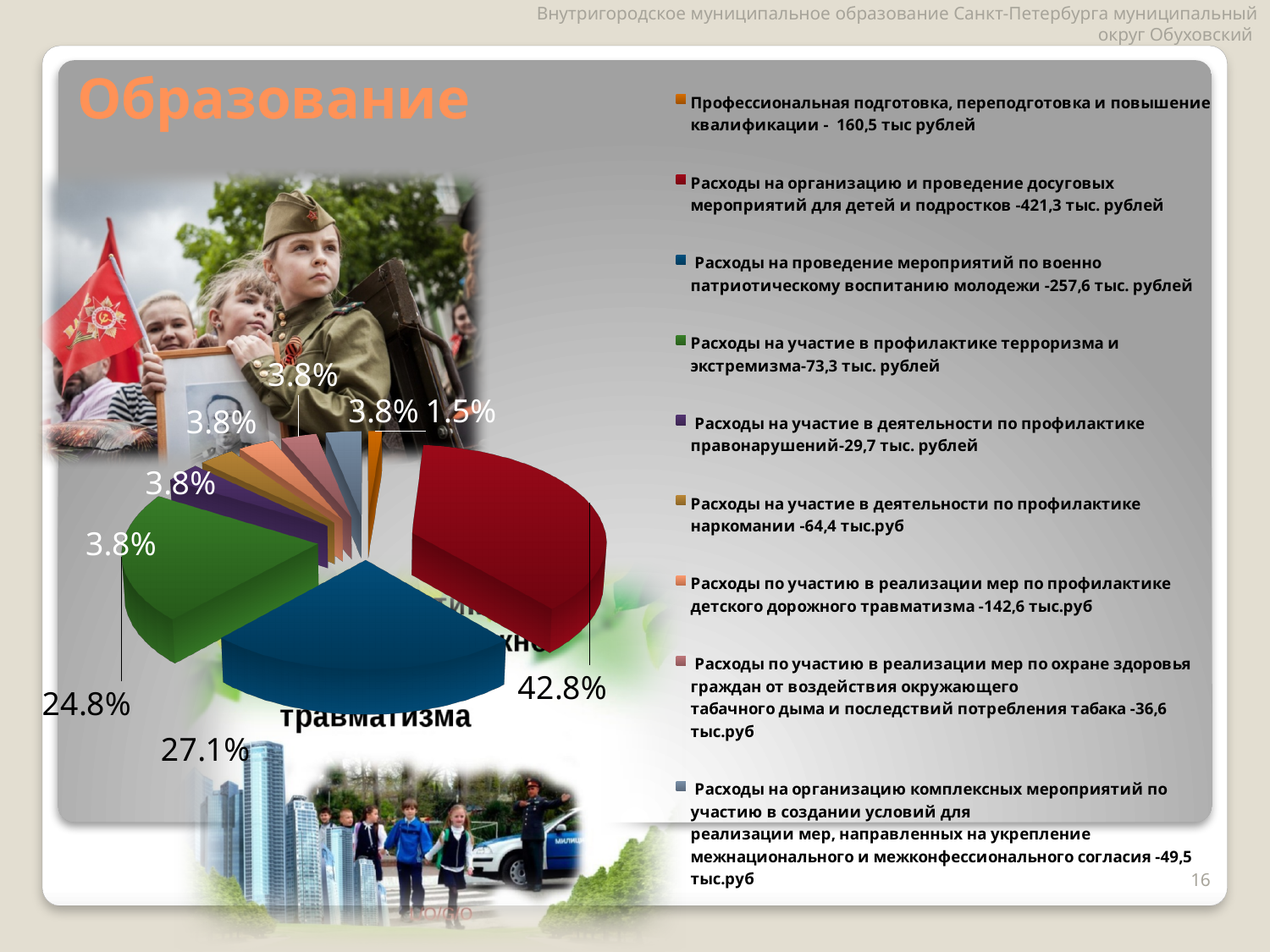
What is the difference in percentage points between the largest slice (42.8%) and the second largest slice (27.1%)? 15.7 Is the largest slice of the pie chart greater or less than 40%? greater What is the percentage shown for the largest slice of the pie chart? 42.8% What is the title of the slide containing the pie chart? Образование What percentage is shown for the green slice of the pie chart? 24.8% Which slice is larger: the red slice or the dark blue slice? the red slice What kind of chart is shown on the slide? pie chart How many slices does the pie chart have? 9 How many entries are listed in the legend on the right of the slide? 9 What is the percentage shown for the smallest slice of the pie chart? 1.5% According to the legend list on the right, what amount is given for 'Расходы на участие в профилактике терроризма и экстремизма'? 73,3 тыс. рублей How many slices of the pie chart are labelled 3.8%? 5